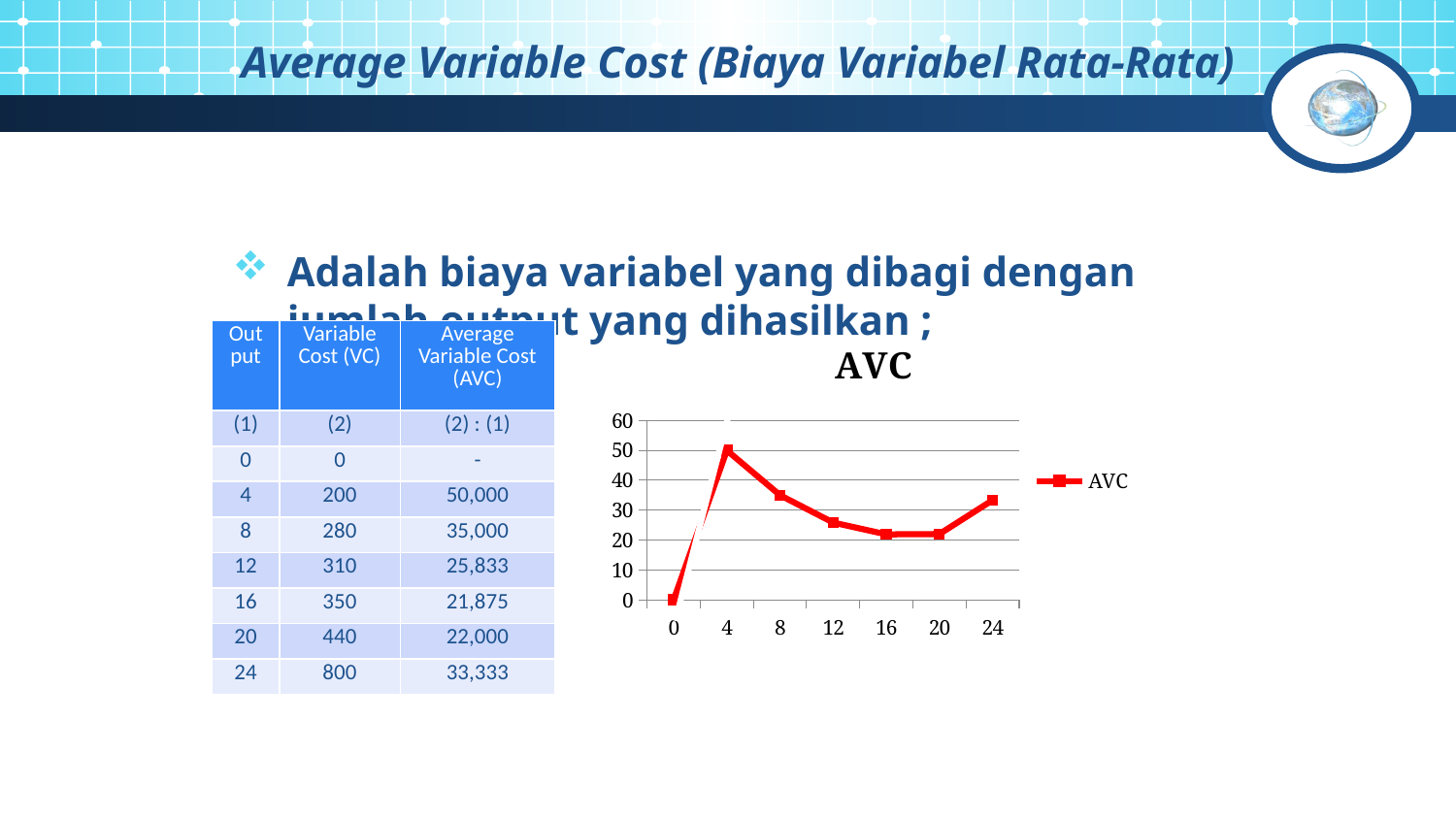
What is the AVC value plotted at output 0? 0 At which output level is the plotted AVC highest? 4 What is the title of the chart? AVC How many series does the chart legend list? 1 At which output level is the plotted AVC lowest? 0 How many data points are plotted on the AVC line? 7 Is the AVC value at output 20 greater or less than 30? less Do the AVC values rise or fall as output increases from 4 to 16? fall What is the AVC value plotted at output 4? 50 Is the AVC value at output 8 greater or less than 30? greater What kind of chart is shown on the slide? line chart Which has a higher plotted AVC value, output 4 or output 8? output 4